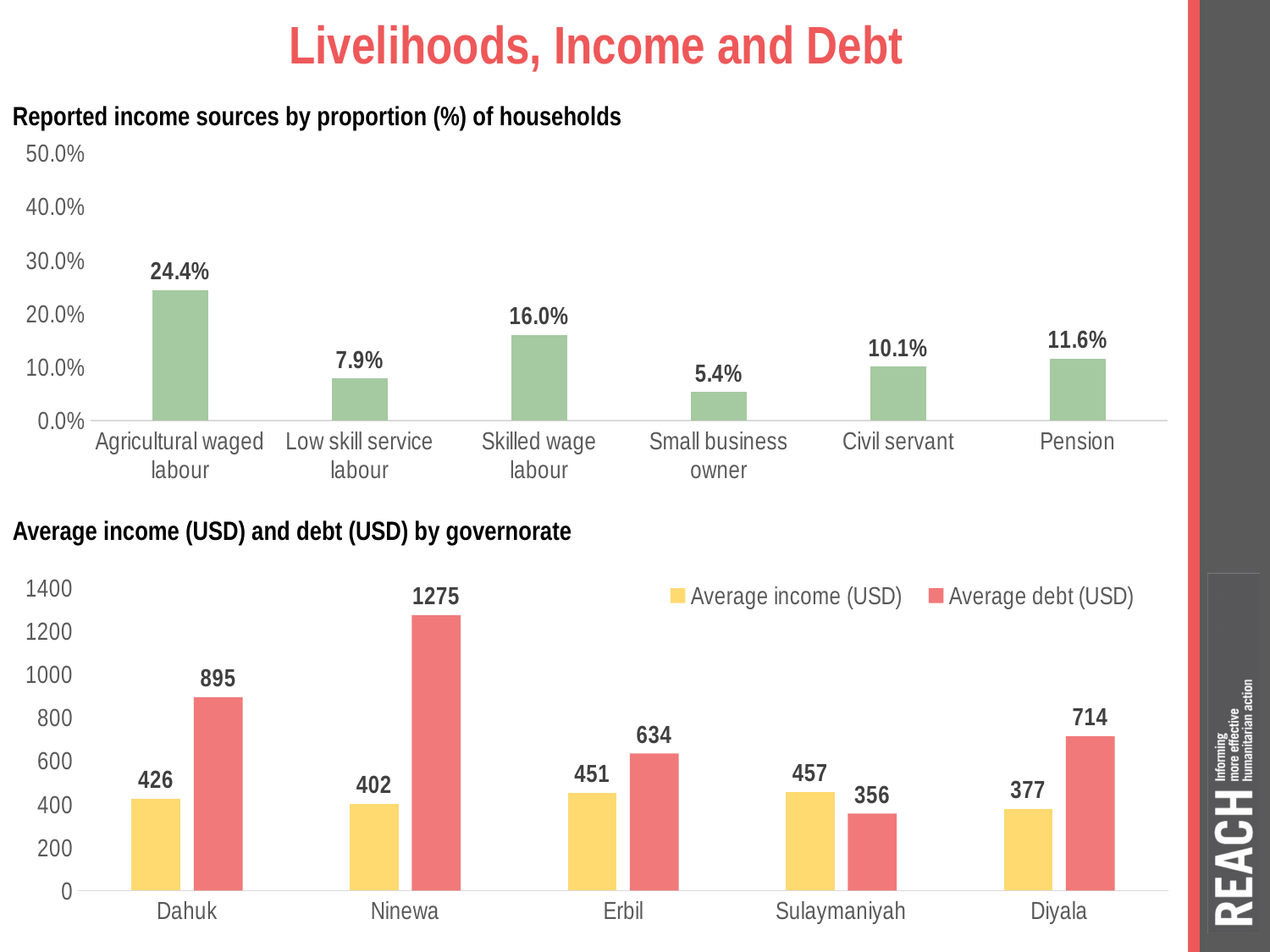
What kind of chart is the 'Average income (USD) and debt (USD) by governorate' chart? Bar chart In the 'Reported income sources by proportion (%) of households' chart, how many income source categories are shown? 6 In the 'Average income (USD) and debt (USD) by governorate' chart, how many series does the legend list? 2 In the 'Average income (USD) and debt (USD) by governorate' chart, what is the average debt for Ninewa? 1275 In the 'Average income (USD) and debt (USD) by governorate' chart, which is larger for Dahuk: average income or average debt? Average debt (USD) In the 'Reported income sources by proportion (%) of households' chart, what is the difference between Pension and Civil servant? 1.5% In the 'Reported income sources by proportion (%) of households' chart, which income source has the lowest proportion of households? Small business owner In the 'Average income (USD) and debt (USD) by governorate' chart, what is the average income for Sulaymaniyah? 457 In the 'Average income (USD) and debt (USD) by governorate' chart, what is the difference between average debt and average income for Erbil? 183 In the 'Average income (USD) and debt (USD) by governorate' chart, which governorate has the lowest average debt? Sulaymaniyah In the 'Reported income sources by proportion (%) of households' chart, what is the value for Skilled wage labour? 16.0% In the 'Reported income sources by proportion (%) of households' chart, which income source has the highest proportion of households? Agricultural waged labour